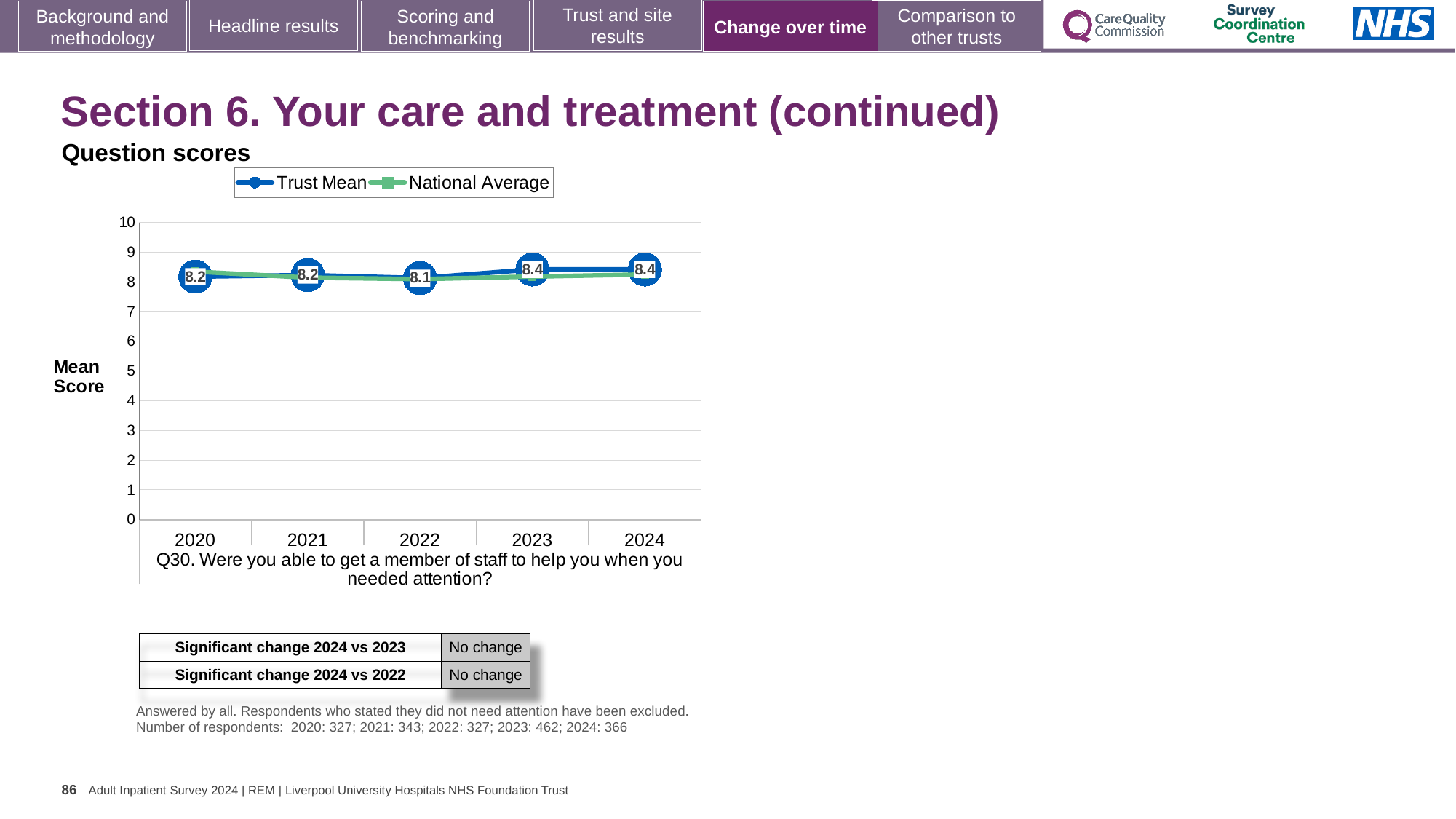
What are the two series named in the legend? Trust Mean and National Average What is the difference between the Trust Mean scores for 2024 and 2022? 0.3 What kind of chart is shown on the slide? line chart In which year is the Trust Mean score lowest? 2022 Does the Trust Mean score rise or fall from 2020 to 2024? rise What is the Trust Mean score for 2022? 8.1 What is the Trust Mean score for 2024? 8.4 Is the Trust Mean value for 2021 greater or less than 5? greater How many years are plotted on the x axis? 5 How many series does the legend list? 2 Which year has the larger Trust Mean score, 2022 or 2023? 2023 What is the Trust Mean score for 2020? 8.2